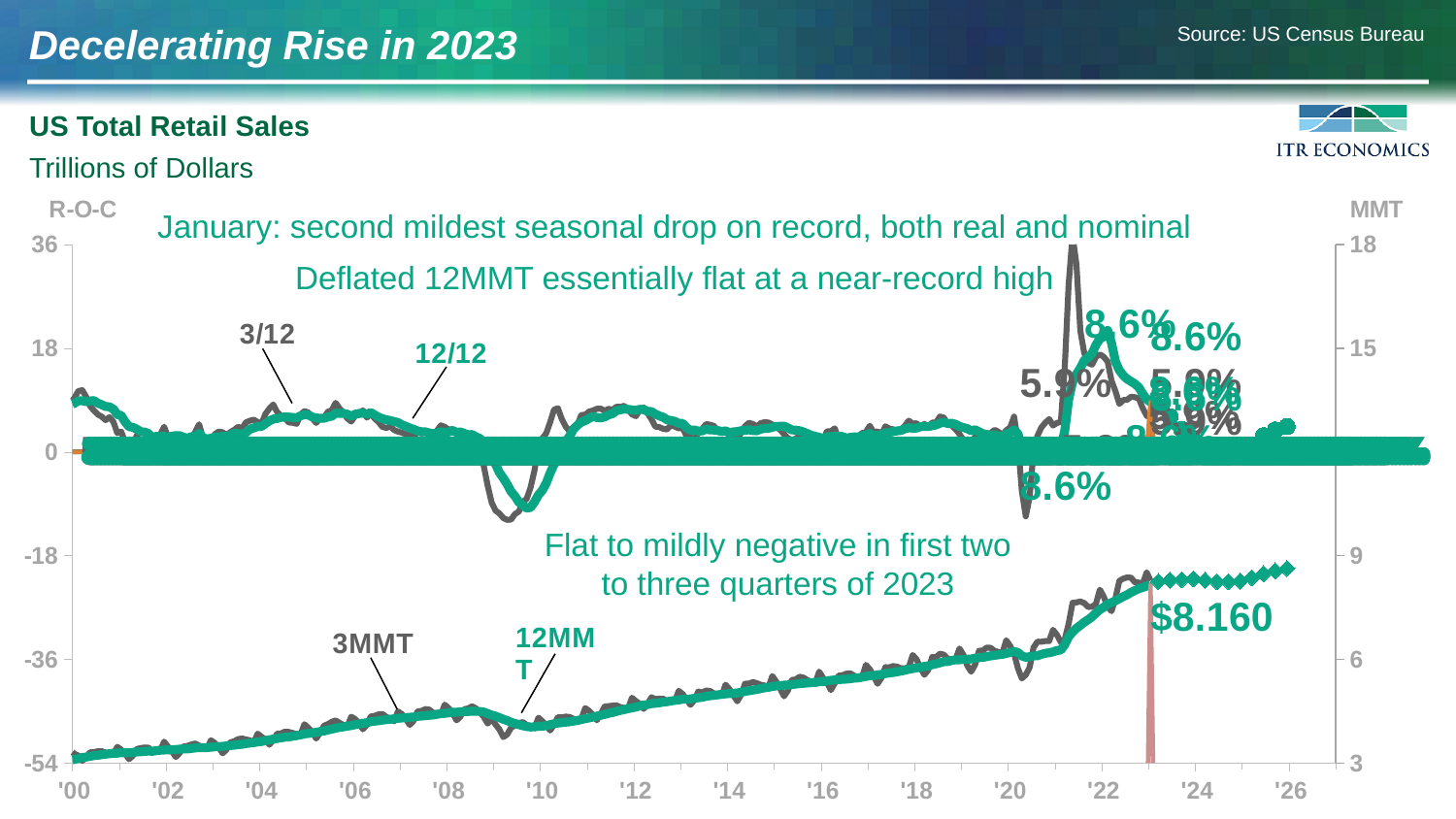
Which is larger, the 12MMT value in 2023 or the 12MMT value in 2010? 2023 What kind of chart is shown on the slide? line chart What label is shown on the left vertical axis of the chart? R-O-C Is the 12MMT value at 2000 greater or less than 6 on the right axis? less What is the labeled value of the 12MMT series at 2023? $8.160 How many data series are labeled on the chart? 4 Is the peak of the 3/12 series around 2021 greater or less than 18 on the left axis? greater Is the 3MMT value around 2020 greater or less than 9 on the right axis? less What is the title of the chart? US Total Retail Sales Does the 12MMT series generally rise or fall from 2000 to 2026? rise